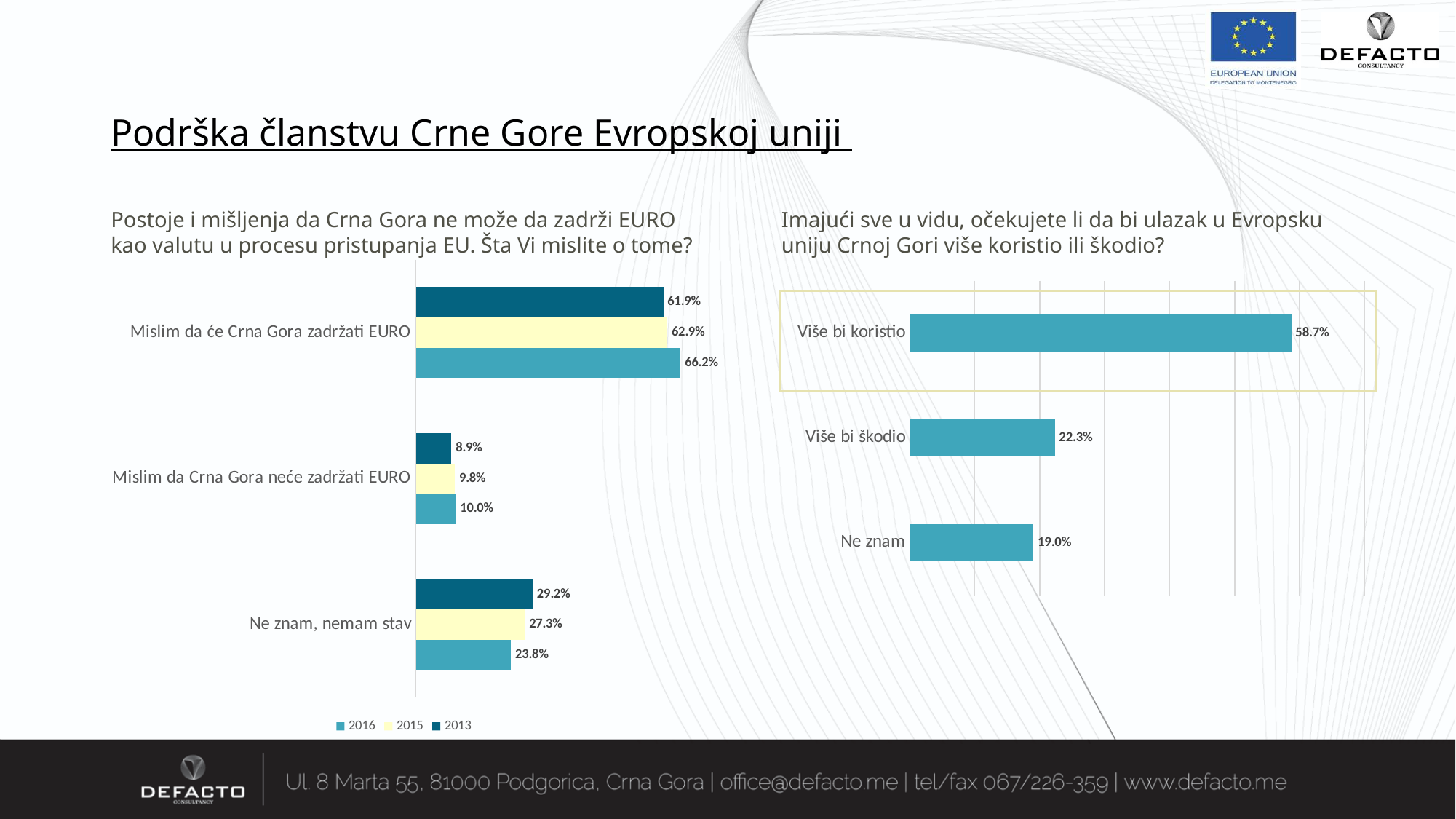
In the left chart, which is larger for "Ne znam, nemam stav": the 2013 value or the 2016 value? 2013 In the left chart, what is the 2016 value for "Mislim da će Crna Gora zadržati EURO"? 66.2% In the right chart, which category has the lowest value? Ne znam What type of chart is the right chart? Bar chart In the right chart, which category has the highest value? Više bi koristio In the right chart, what is the value for "Više bi škodio"? 22.3% In the left chart, what is the 2015 value for "Mislim da Crna Gora neće zadržati EURO"? 9.8% In the left chart, what is the difference between the 2016 and 2013 values for "Mislim da će Crna Gora zadržati EURO"? 4.3% How many series does the legend of the left chart list? 3 In the left chart, what is the 2013 value for "Ne znam, nemam stav"? 29.2% In the right chart, what is the difference between "Više bi koristio" and "Više bi škodio"? 36.4% How many categories are shown in the right chart? 3